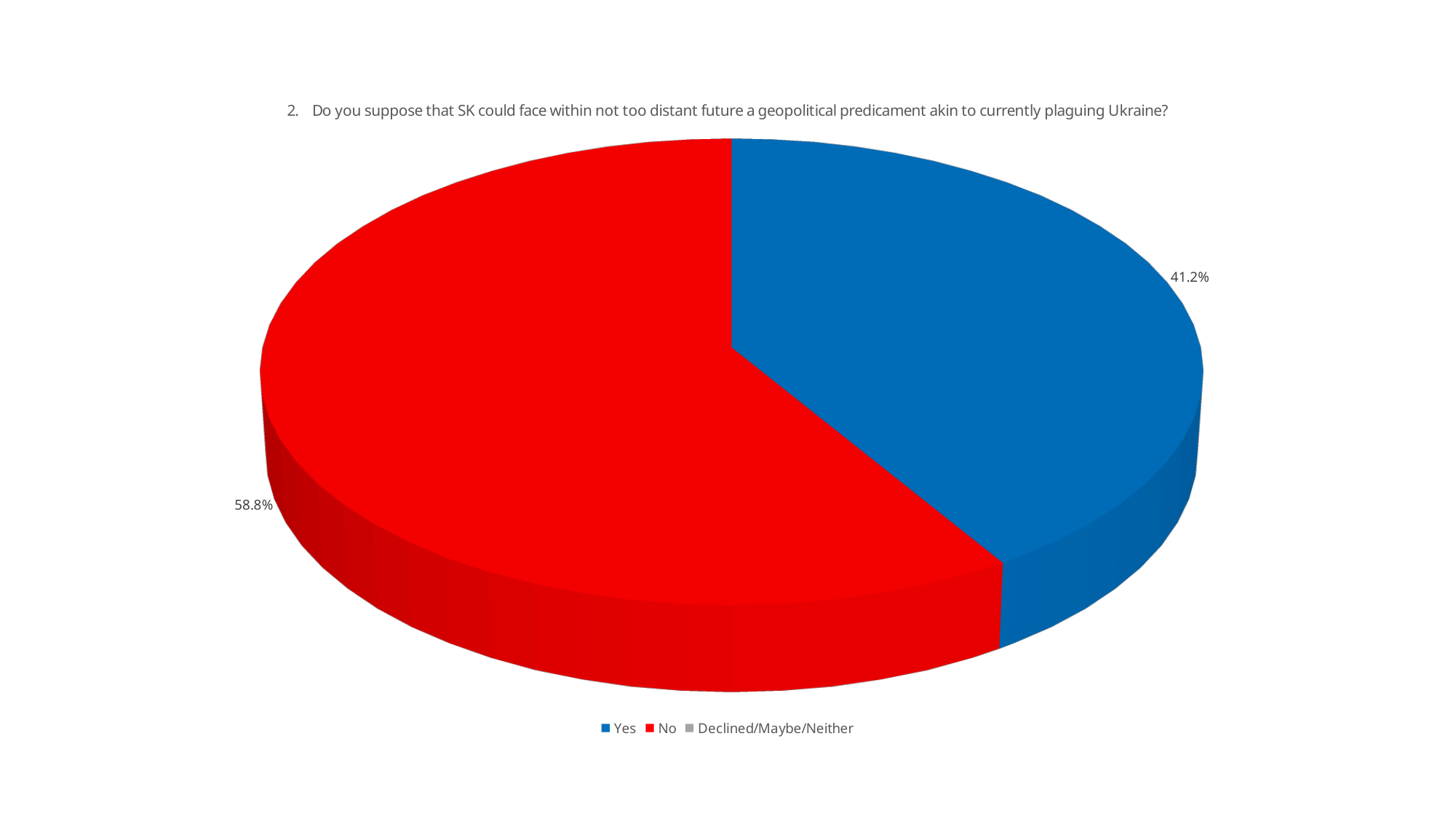
What colour is the "Yes" slice? blue Which response has the largest slice of the pie? No Which of the two visible slices, Yes or No, is smaller? Yes Is the "No" slice larger or smaller than the "Yes" slice? larger Is the share for "Yes" greater or less than 50%? less What share of the pie does the "No" slice represent? 58.8% What is the third legend entry, after Yes and No? Declined/Maybe/Neither What is the difference in percentage points between the "No" and "Yes" slices? 17.6 How many slices are visible in the pie? 2 What kind of chart is shown on the slide? pie chart How many entries does the legend list? 3 What share of the pie does the "Yes" slice represent? 41.2%